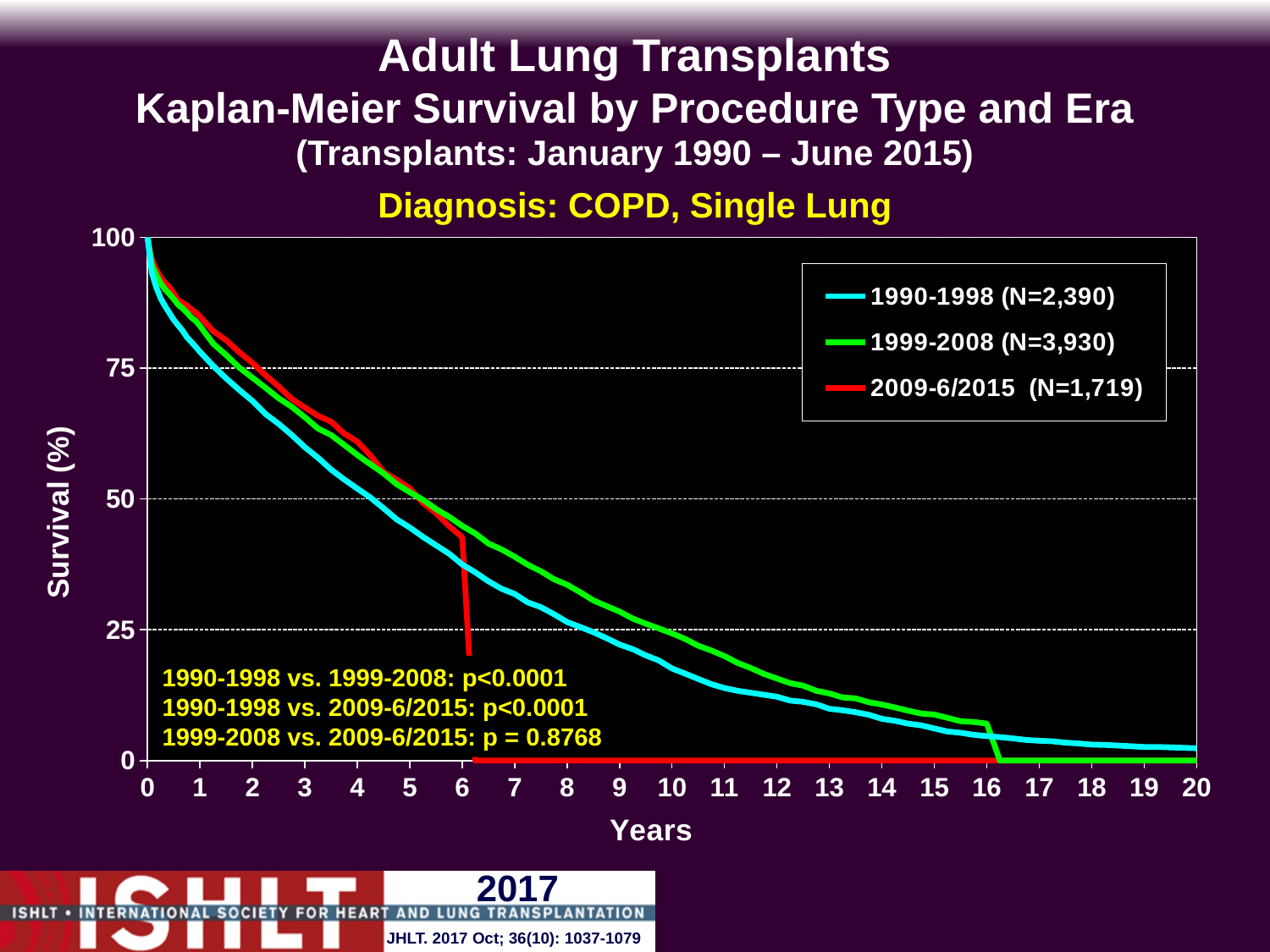
What is the N for the 2009-6/2015 era shown in the legend? 1,719 Is the survival for the 1990-1998 era at 5 years greater or less than 50%? less Is the survival for the 1999-2008 era at 15 years greater or less than 25%? less What kind of chart is shown on the slide? Line chart What is the N for the 1990-1998 era shown in the legend? 2,390 What is the p-value shown for 1999-2008 vs. 2009-6/2015? p = 0.8768 What is the N for the 1999-2008 era shown in the legend? 3,930 What is the difference between the N for 1999-2008 and the N for 1990-1998? 1,540 Do the survival curves rise or fall as years increase? Fall Which era has the largest N in the legend? 1999-2008 How many series does the legend list? 3 At 3 years, which era has higher survival, 1990-1998 or 1999-2008? 1999-2008